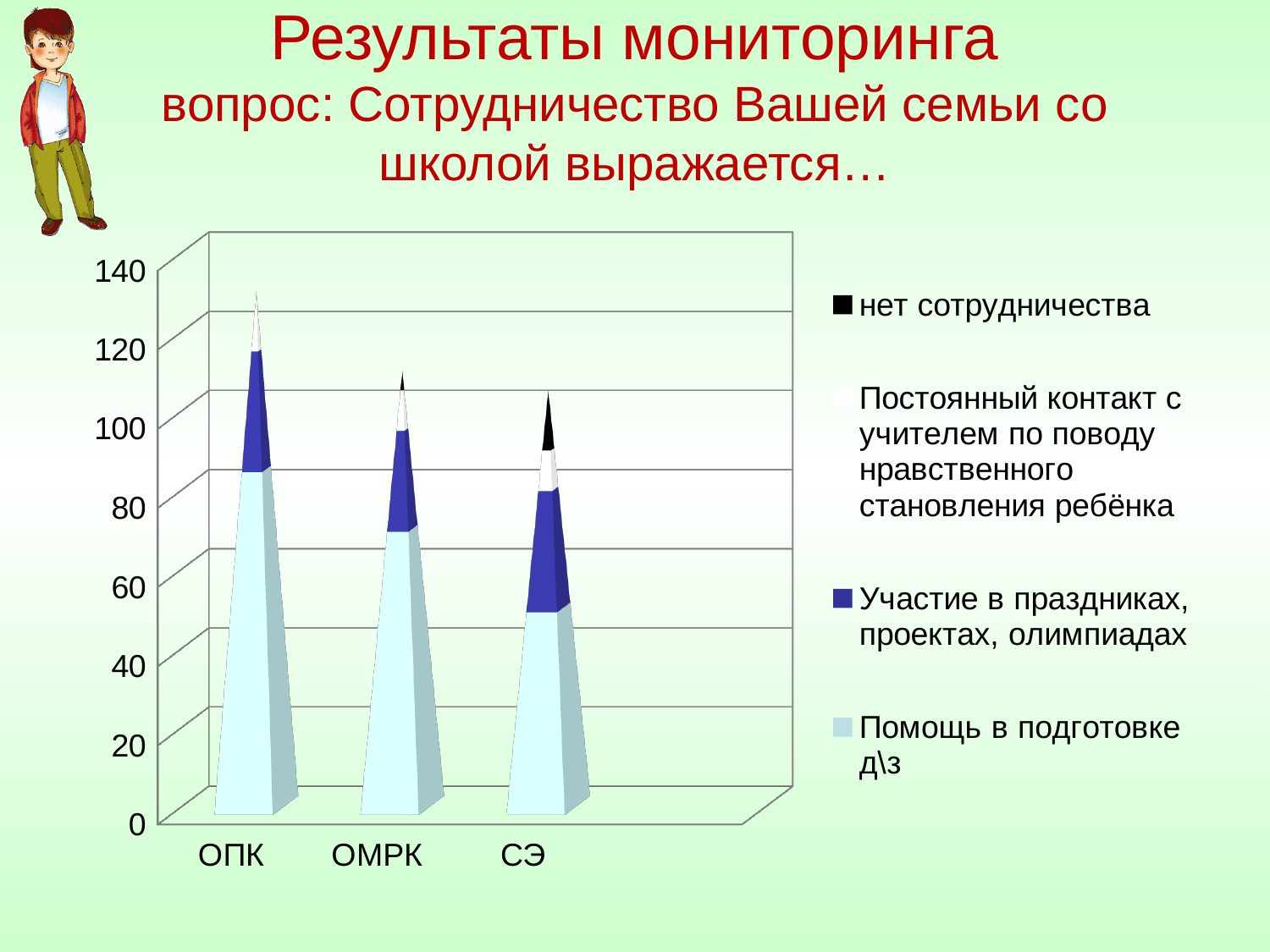
Which legend entry is shown in black? нет сотрудничества Is the total height of the bar for СЭ greater or less than 120? less How many series does the chart legend list? 4 What kind of chart is shown on the slide? Stacked bar chart Is the value of the 'Помощь в подготовке д\з' segment for СЭ greater or less than 60? less Is the total height of the bar for ОМРК greater or less than 100? greater Which category has the tallest stacked bar? ОПК What is the highest value shown on the vertical axis of the chart? 140 How many categories are shown on the x axis of the chart? 3